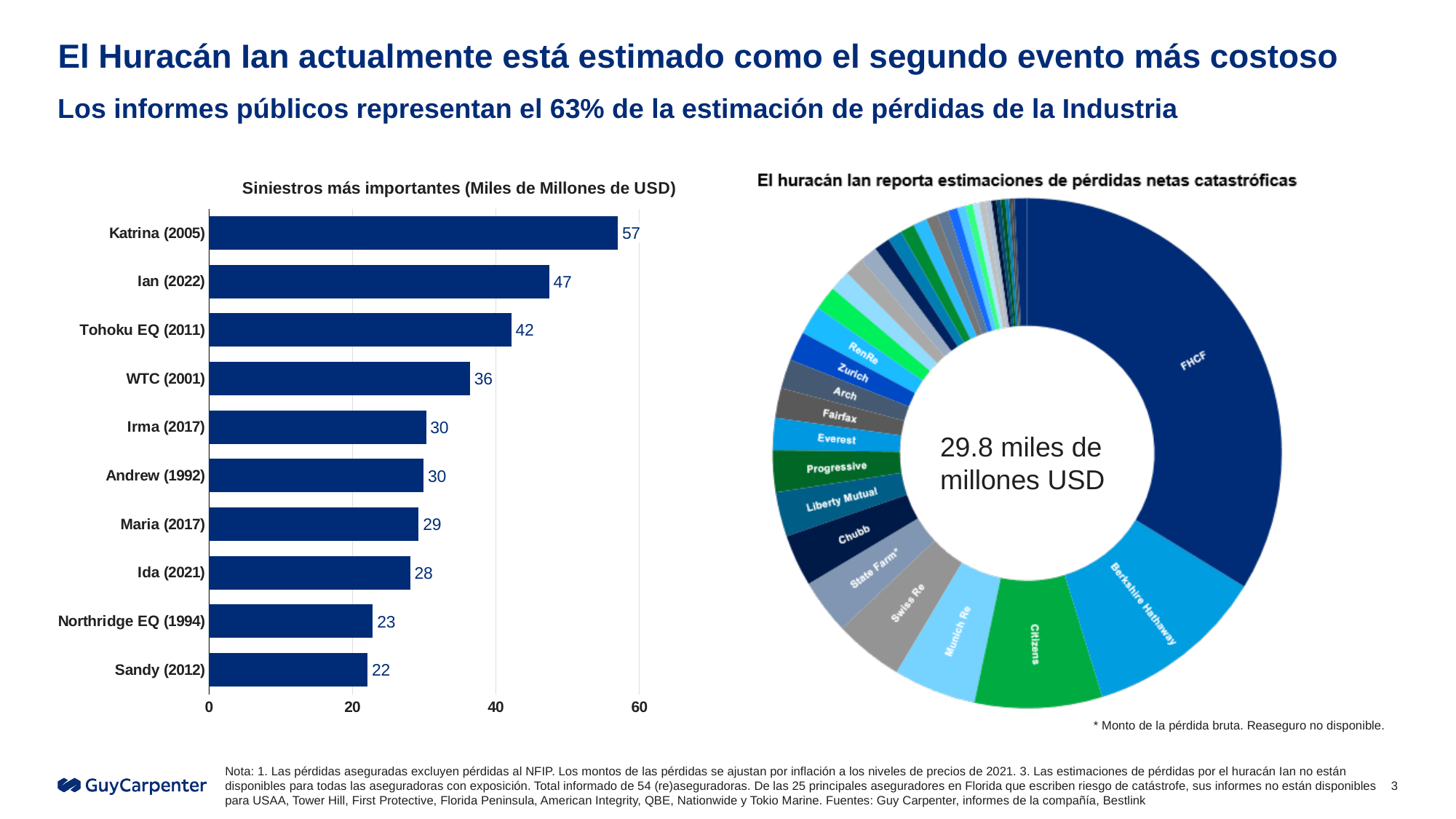
In the chart 'Siniestros más importantes (Miles de Millones de USD)', which event has the highest value? Katrina (2005) What kind of chart is 'Siniestros más importantes (Miles de Millones de USD)'? Bar chart In the chart 'Siniestros más importantes (Miles de Millones de USD)', what is the difference between the values for Katrina (2005) and Ian (2022)? 10 In the chart 'Siniestros más importantes (Miles de Millones de USD)', how many events are shown? 10 In the chart 'Siniestros más importantes (Miles de Millones de USD)', what is the value for Northridge EQ (1994)? 23 In the chart 'El huracán Ian reporta estimaciones de pérdidas netas catastróficas', which company has the largest slice? FHCF In the chart 'Siniestros más importantes (Miles de Millones de USD)', which is larger, the value for Tohoku EQ (2011) or WTC (2001)? Tohoku EQ (2011) What kind of chart is 'El huracán Ian reporta estimaciones de pérdidas netas catastróficas'? Donut (pie) chart In the chart 'Siniestros más importantes (Miles de Millones de USD)', what is the value for Katrina (2005)? 57 In the chart 'Siniestros más importantes (Miles de Millones de USD)', what is the value for Ian (2022)? 47 In the chart 'Siniestros más importantes (Miles de Millones de USD)', which event has the lowest value? Sandy (2012) In the chart 'Siniestros más importantes (Miles de Millones de USD)', is the value for Ida (2021) greater or less than 20? greater